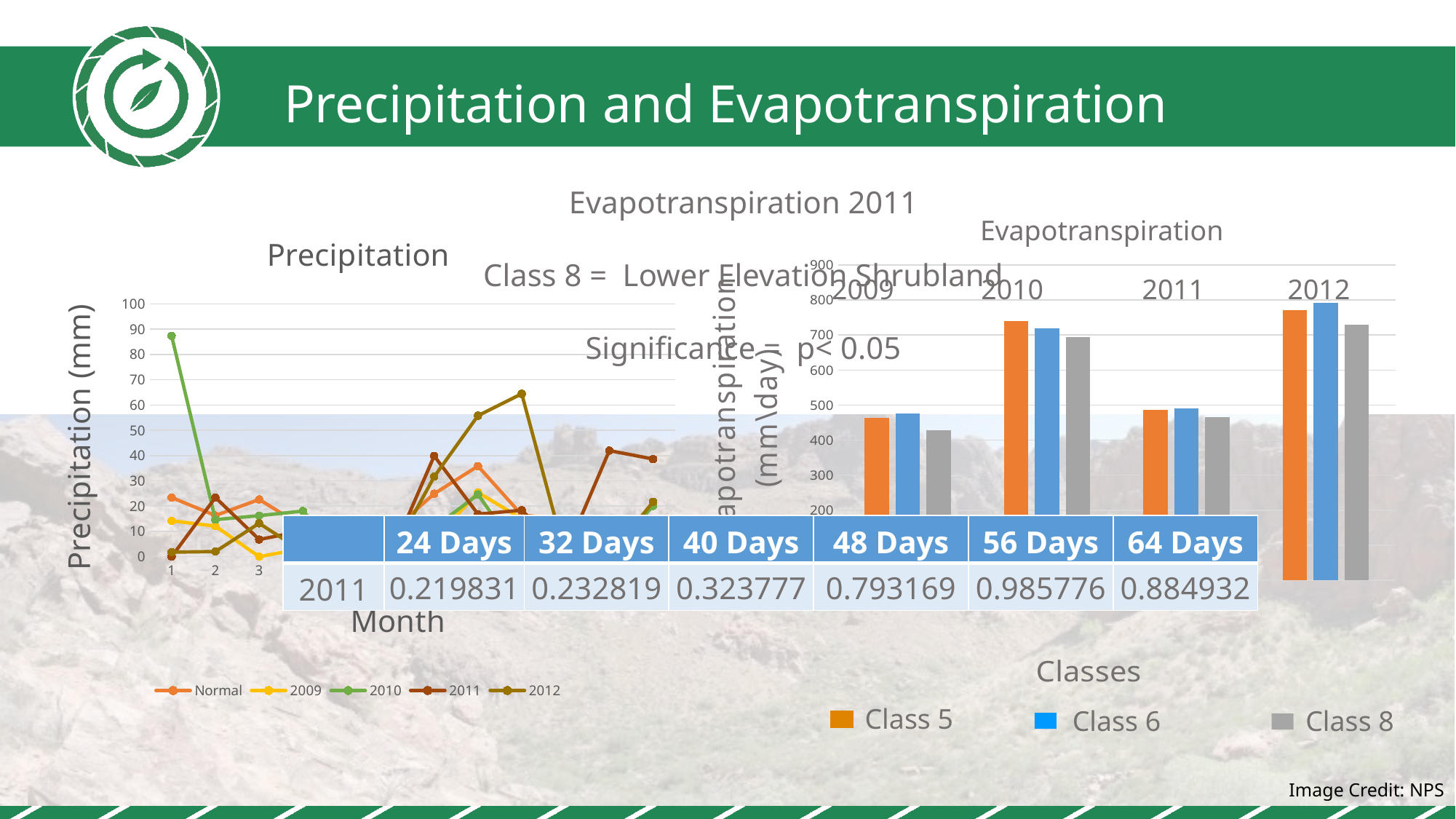
In the Evapotranspiration chart, which year has the highest Class 6 bar? 2012 What kind of chart is the Evapotranspiration chart on the right? bar chart In the Evapotranspiration chart, which year has the lowest Class 8 bar? 2009 In the Evapotranspiration chart, which is larger: the Class 5 bar for 2010 or the Class 5 bar for 2011? 2010 In the Evapotranspiration chart, is the Class 8 value for 2009 greater or less than 500? less How many series does the legend of the Evapotranspiration chart list? 3 How many series does the legend of the Precipitation chart list? 5 What kind of chart is the Precipitation chart on the left? line chart How many year categories are shown on the x axis of the Evapotranspiration chart? 4 In the Evapotranspiration chart, is the Class 5 value for 2010 greater or less than 700? greater What is the title of the legend on the Evapotranspiration chart? Classes In the Precipitation chart, is the 2010 value at month 1 greater or less than 80? greater